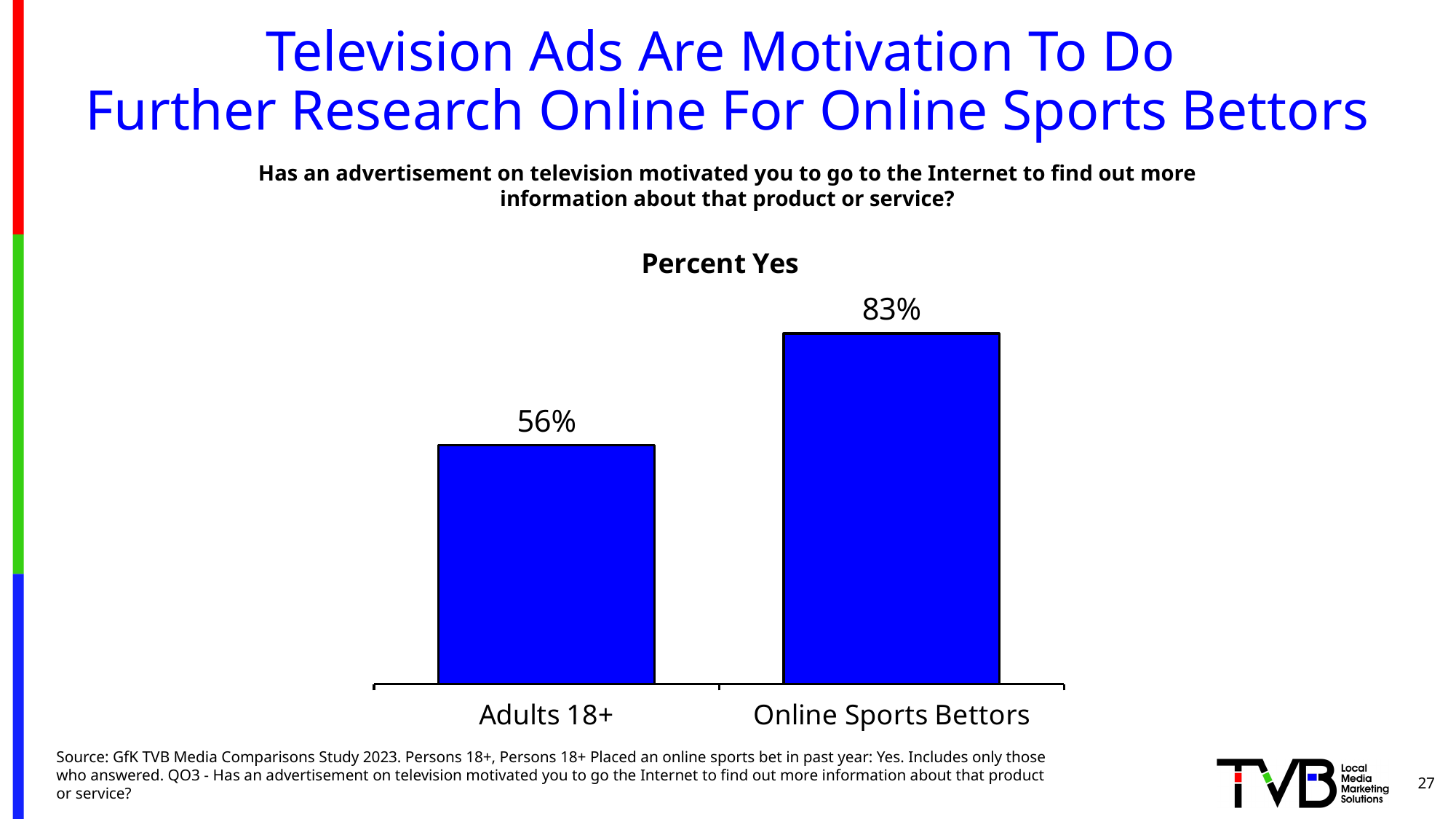
What is the title of the chart? Percent Yes Which is larger, the Percent Yes for Adults 18+ or for Online Sports Bettors? Online Sports Bettors What kind of chart is shown on the slide? Bar chart What is the Percent Yes value for Online Sports Bettors? 83% Which category has the highest Percent Yes value? Online Sports Bettors What is the difference in Percent Yes between Online Sports Bettors and Adults 18+? 27 percentage points Which category has the lowest Percent Yes value? Adults 18+ How many categories are shown in the chart? 2 What is the Percent Yes value for Adults 18+? 56% What colour are the bars in the chart? Blue